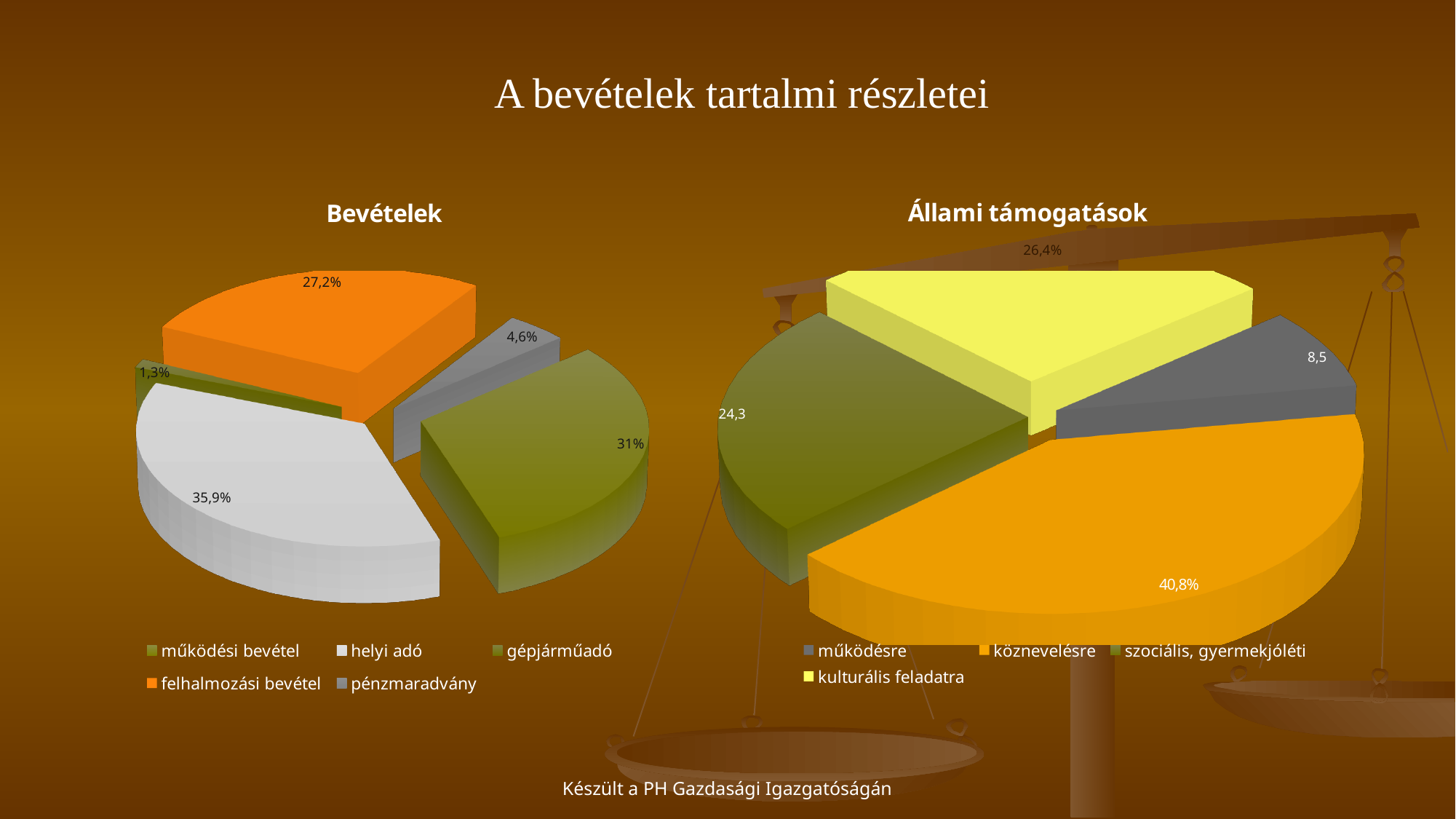
In the Bevételek chart, which category has the largest share? helyi adó In the Állami támogatások chart, which category has the smallest share? működésre In the Bevételek chart, what is the value for felhalmozási bevétel? 27,2% In the Bevételek chart, what is the difference between helyi adó and működési bevétel? 4,9% In the Bevételek chart, how many categories does the legend list? 5 In the Állami támogatások chart, which is larger, szociális, gyermekjóléti or kulturális feladatra? kulturális feladatra In the Bevételek chart, which category has the smallest share? gépjárműadó What type of chart is the Állami támogatások chart? pie chart In the Bevételek chart, what is the value for helyi adó? 35,9% In the Bevételek chart, what is the value for pénzmaradvány? 4,6% In the Állami támogatások chart, what is the value for kulturális feladatra? 26,4% In the Állami támogatások chart, what is the value for köznevelésre? 40,8%